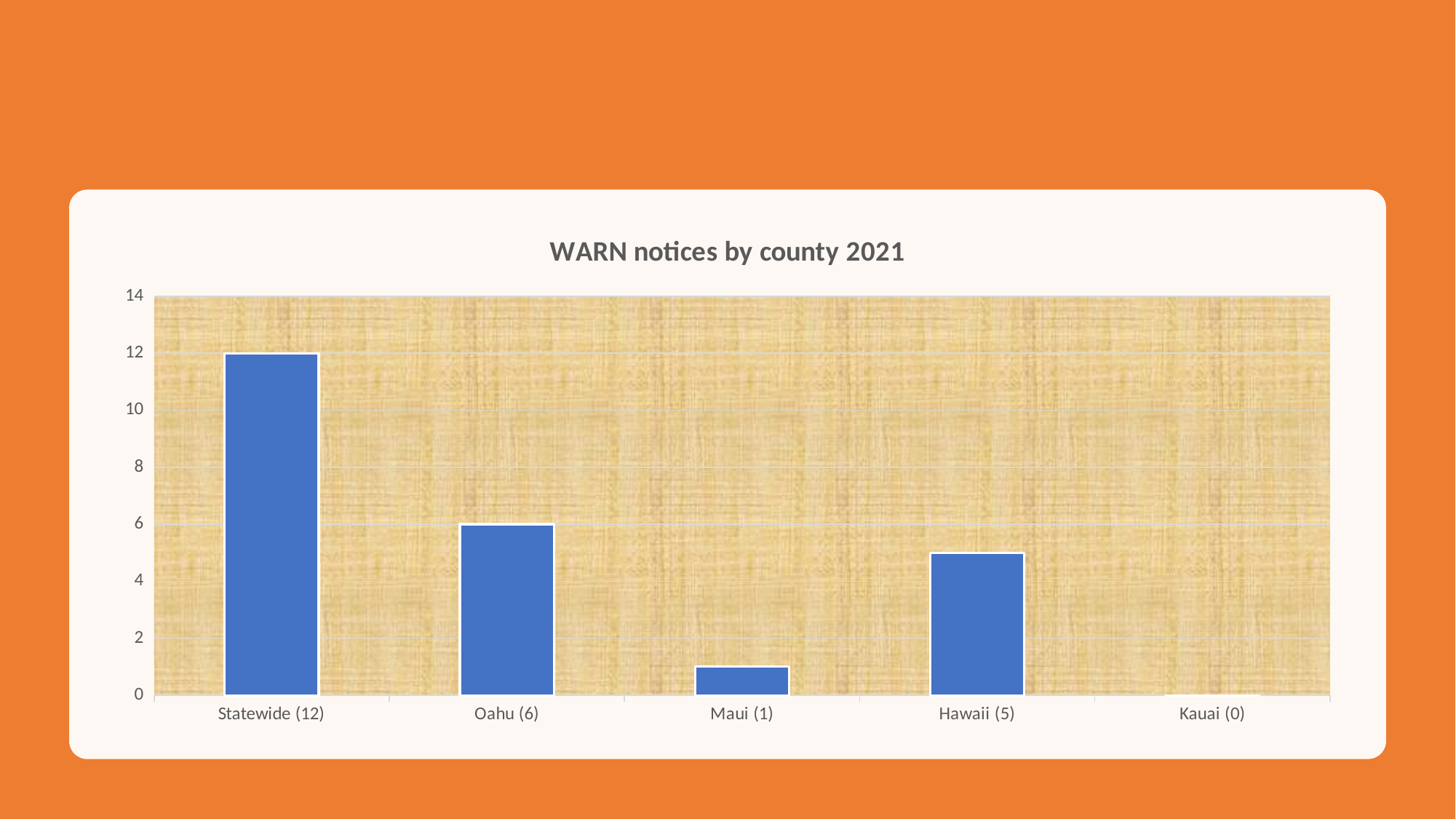
What is the value for Oahu? 6 What type of chart is shown on the slide? bar chart Which category has the highest value? Statewide What is the value for Kauai? 0 What is the value for Maui? 1 Which is larger, the value for Oahu or the value for Hawaii? Oahu What is the title of the chart? WARN notices by county 2021 Is the value for Statewide greater or less than 10? greater What is the difference between the Statewide value and the Oahu value? 6 What is the value for Hawaii? 5 How many categories are shown on the x axis? 5 Which category has the lowest value? Kauai